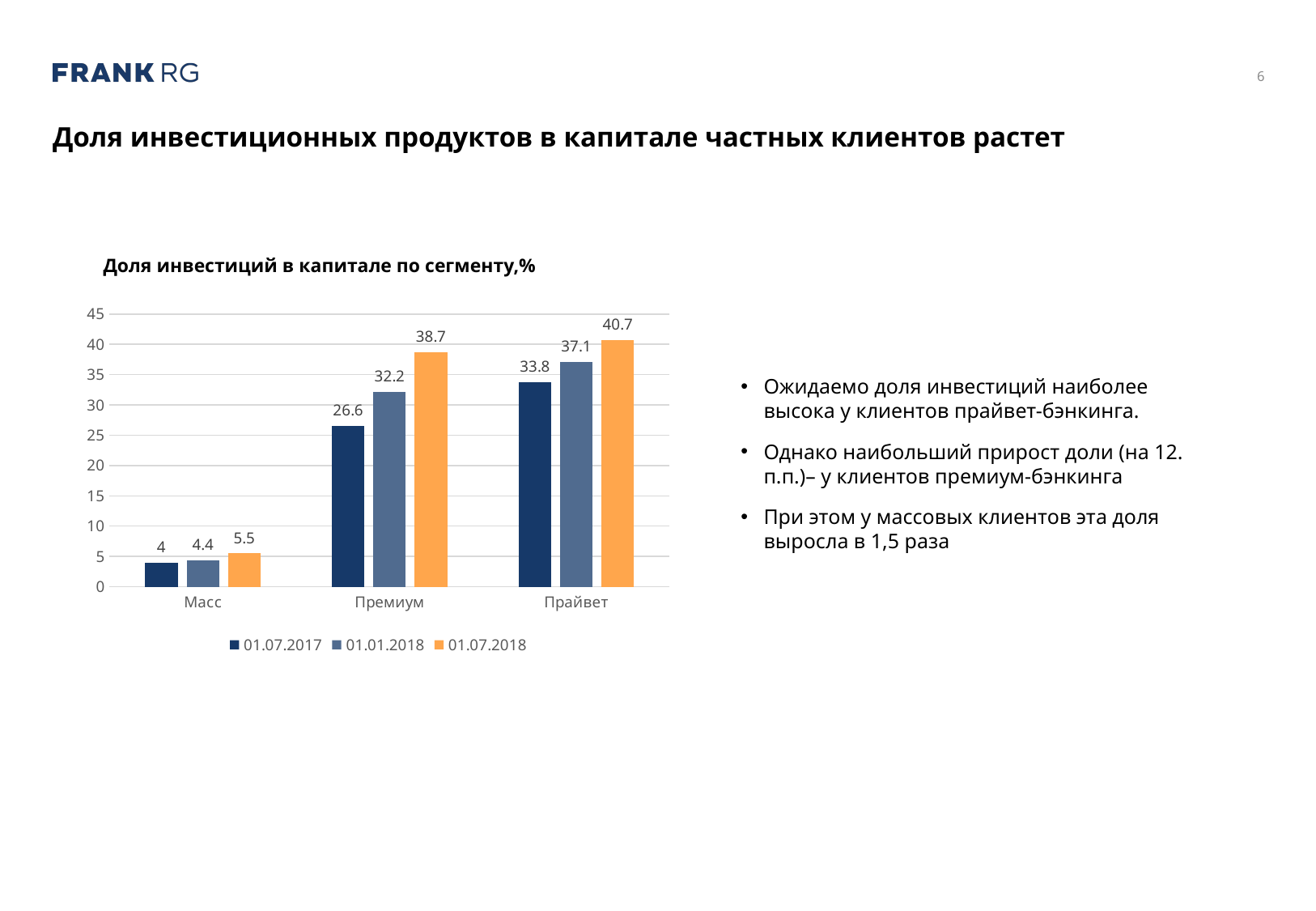
What is the value for Премиум in the 01.01.2018 series? 32.2 What is the title of the chart? Доля инвестиций в капитале по сегменту,% What is the difference between the 01.07.2018 and 01.07.2017 values for Премиум? 12.1 How many categories are shown on the x axis? 3 Is the 01.07.2017 value for Премиум greater or less than 25? greater Which is larger: the 01.01.2018 value for Прайвет or the 01.07.2018 value for Премиум? 01.07.2018 value for Премиум Which category has the lowest value in the 01.07.2017 series? Масс What kind of chart is shown on the slide? bar chart How many series does the legend list? 3 Which category has the highest value in the 01.07.2018 series? Прайвет What is the value for Прайвет in the 01.07.2017 series? 33.8 What is the value for Масс in the 01.07.2018 series? 5.5